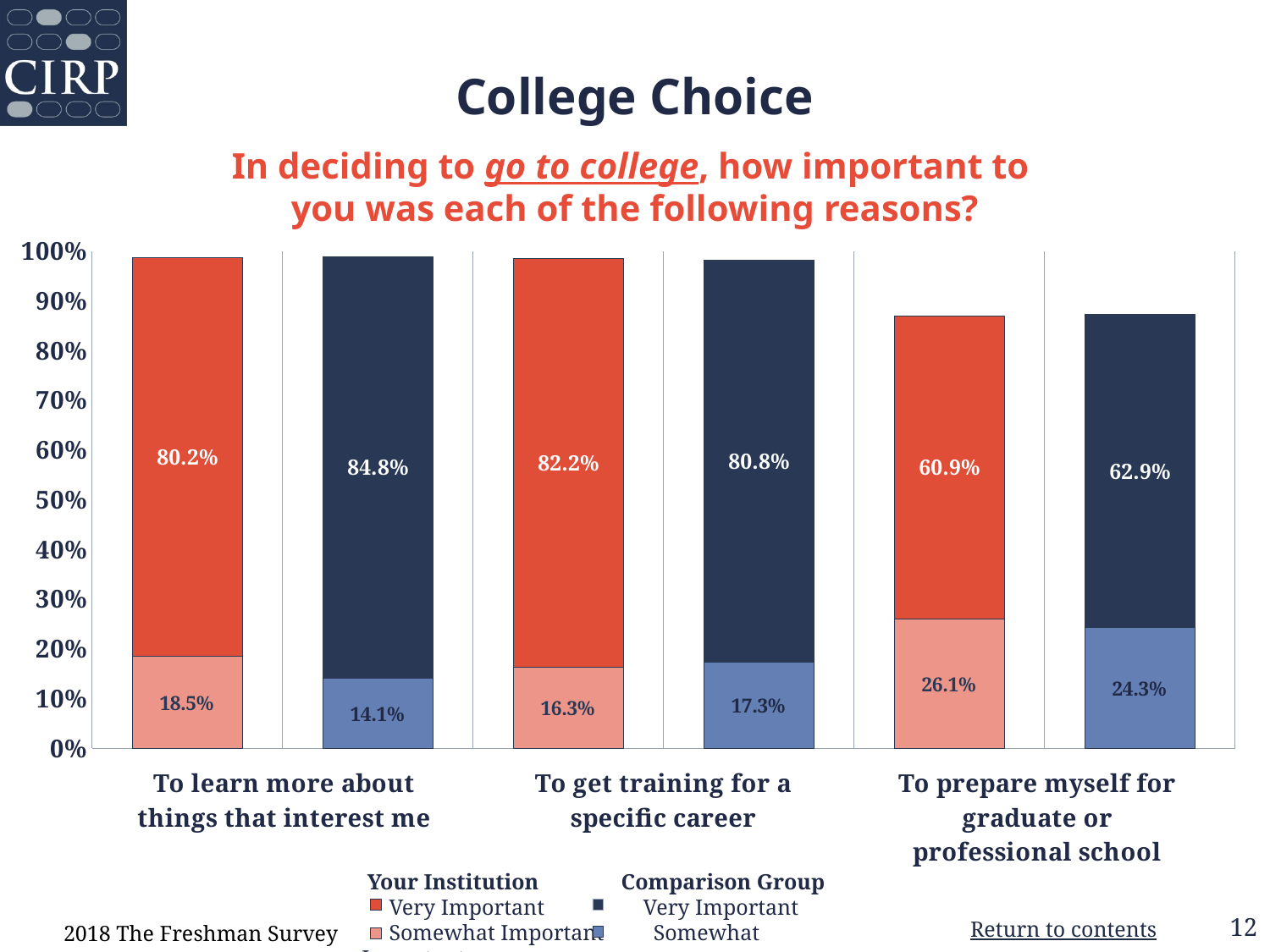
Which reason has the highest Very Important percentage for Your Institution? To get training for a specific career What percentage of Your Institution students rated "To prepare myself for graduate or professional school" as Somewhat Important? 26.1% How many series does the chart legend list? 4 What is the combined Very Important and Somewhat Important percentage for the Comparison Group on "To learn more about things that interest me"? 98.9% How many reasons (categories) are shown on the x axis of the chart? 3 For "To prepare myself for graduate or professional school", which group has the larger Very Important percentage, Your Institution or the Comparison Group? Comparison Group What is the combined Very Important and Somewhat Important percentage for Your Institution on "To prepare myself for graduate or professional school"? 87.0% What percentage of Your Institution students rated "To learn more about things that interest me" as Very Important? 80.2% What kind of chart is shown on the slide? Stacked bar chart What is the difference between the Comparison Group and Your Institution Very Important percentages for "To learn more about things that interest me"? 4.6% Which reason has the lowest Very Important percentage for the Comparison Group? To prepare myself for graduate or professional school What percentage of the Comparison Group rated "To get training for a specific career" as Somewhat Important? 17.3%